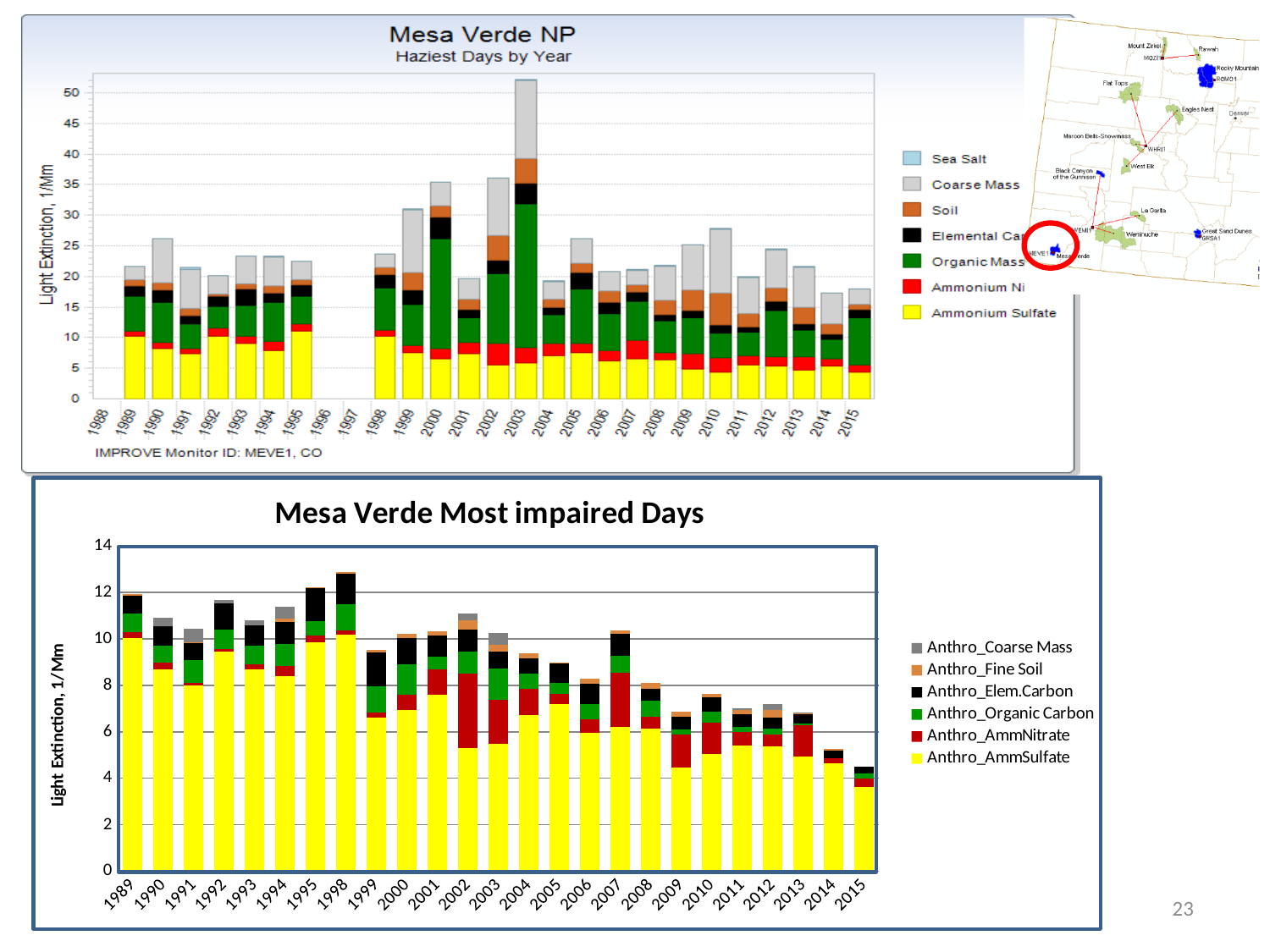
What kind of chart is the bottom chart 'Mesa Verde Most impaired Days'? Stacked bar chart How many series does the legend of the bottom chart 'Mesa Verde Most impaired Days' list? 6 In the top chart 'Mesa Verde NP Haziest Days by Year', is the total value for 2014 greater or less than 20? less In the bottom chart 'Mesa Verde Most impaired Days', do the total bar heights generally rise or fall from 1989 to 2015? fall In the top chart 'Mesa Verde NP Haziest Days by Year', is the total value for 2003 greater or less than 45? greater In the bottom chart 'Mesa Verde Most impaired Days', is the total value for 2015 greater or less than 6? less In the bottom chart titled 'Mesa Verde Most impaired Days', which year has the shortest stacked bar? 2015 In the bottom chart titled 'Mesa Verde Most impaired Days', which year has the tallest stacked bar? 1998 In the top chart titled 'Mesa Verde NP Haziest Days by Year', which year has the tallest stacked bar? 2003 In the bottom chart 'Mesa Verde Most impaired Days', which year has the larger total bar, 1995 or 2013? 1995 How many series does the legend of the top chart 'Mesa Verde NP Haziest Days by Year' list? 7